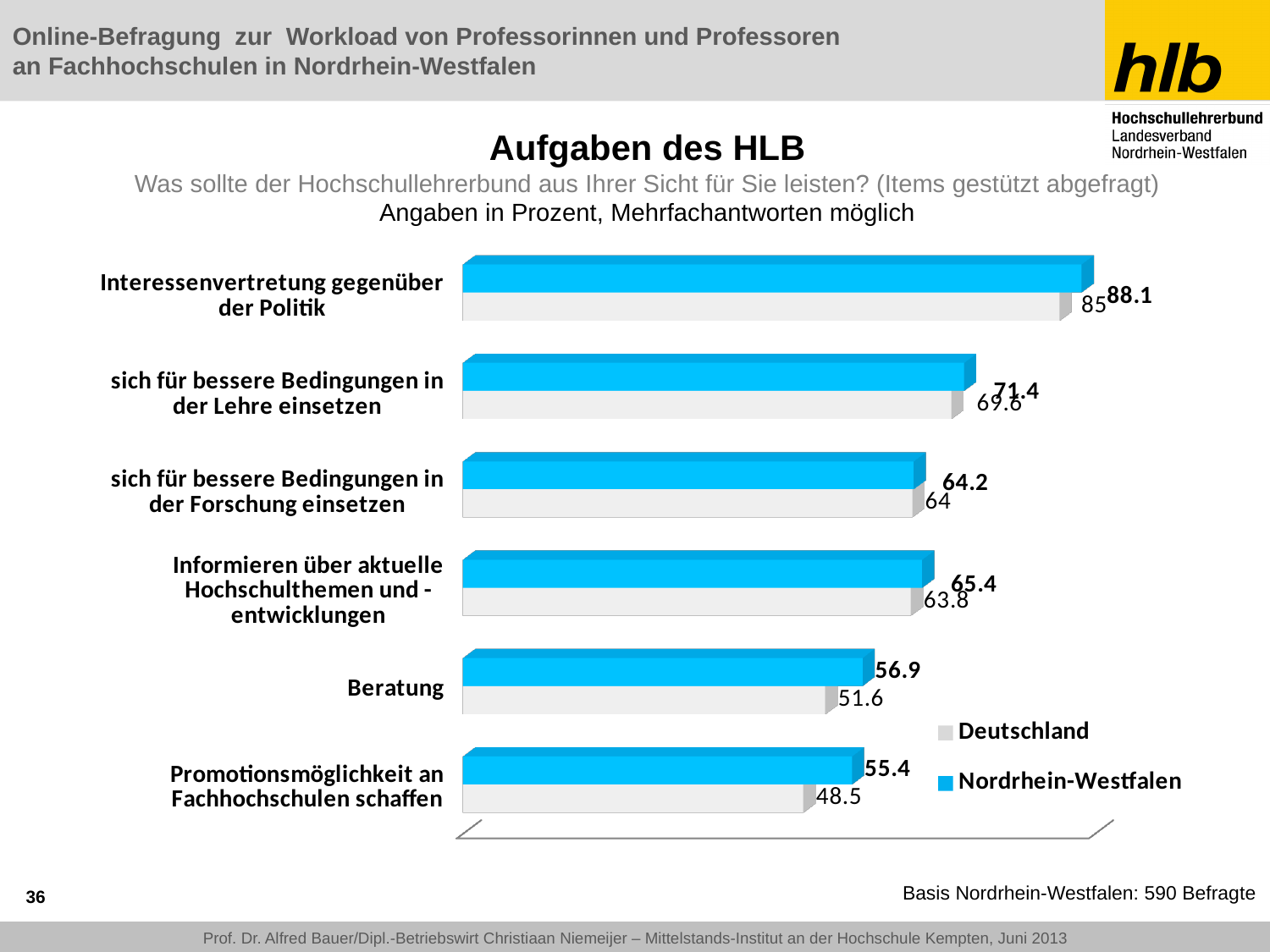
What is the value for Deutschland for "Informieren über aktuelle Hochschulthemen und -entwicklungen"? 63.8 What kind of chart is shown on the slide? Bar chart What is the value for Nordrhein-Westfalen for "Interessenvertretung gegenüber der Politik"? 88.1 Which category has the highest value for Nordrhein-Westfalen? Interessenvertretung gegenüber der Politik How many categories are shown in the chart? 6 What is the difference between the Nordrhein-Westfalen and Deutschland values for "Promotionsmöglichkeit an Fachhochschulen schaffen"? 6.9 How many series does the legend list? 2 What is the value for Nordrhein-Westfalen for "Promotionsmöglichkeit an Fachhochschulen schaffen"? 55.4 For "Beratung", which is larger: the value for Nordrhein-Westfalen or for Deutschland? Nordrhein-Westfalen Which category has the lowest value for Deutschland? Promotionsmöglichkeit an Fachhochschulen schaffen What is the difference between the Nordrhein-Westfalen and Deutschland values for "Beratung"? 5.3 What is the value for Deutschland for "Beratung"? 51.6